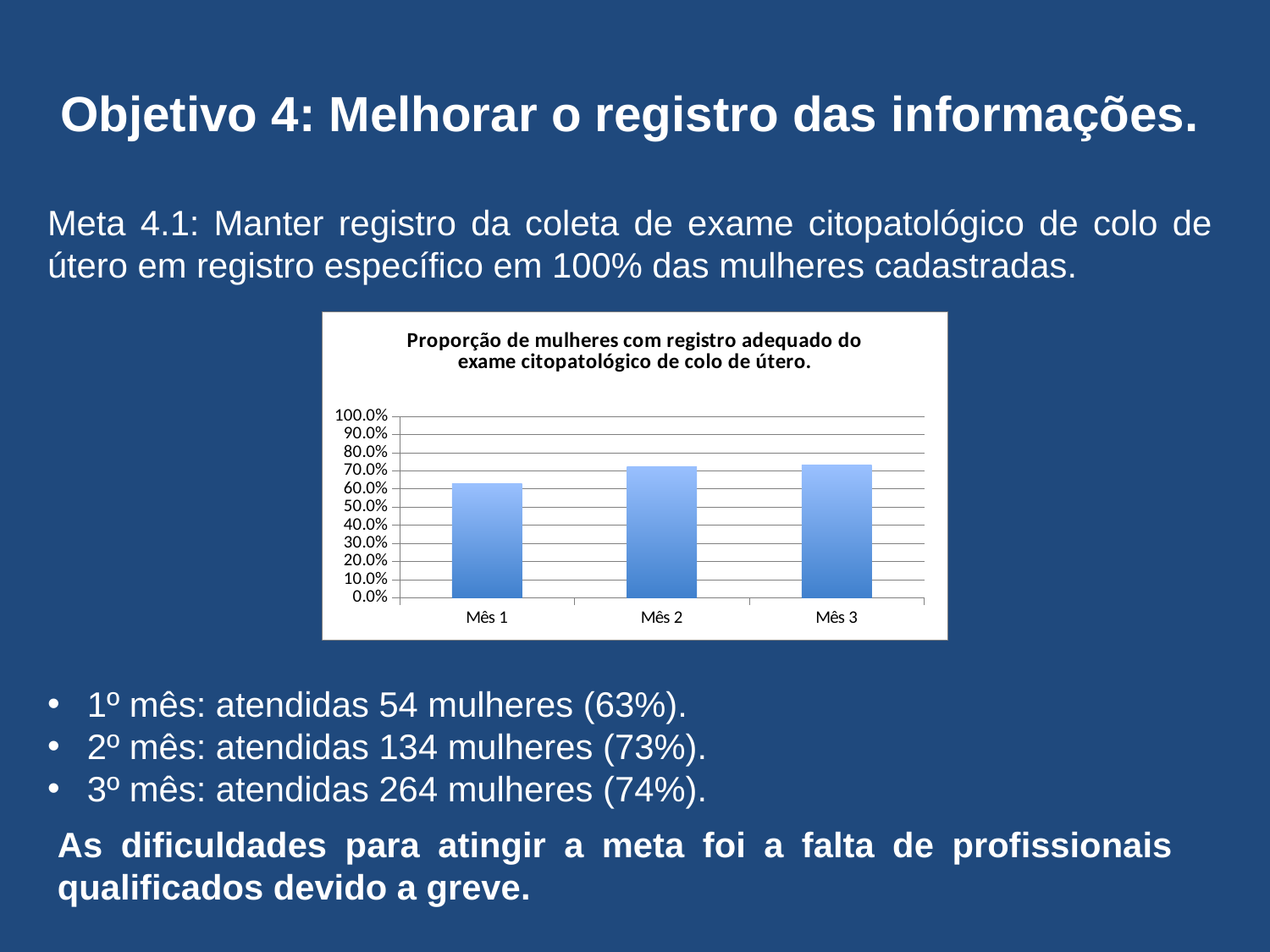
Is the value for Mês 1 greater or less than 70%? less What is the highest value shown on the chart's vertical axis? 100.0% Do the values rise or fall from Mês 1 to Mês 3? rise Is the value for Mês 3 greater or less than 60%? greater Is the value for Mês 2 greater or less than 80%? less How many categories (months) are plotted on the chart? 3 What kind of chart is shown on the slide? bar chart Which is larger, the value for Mês 1 or the value for Mês 2? Mês 2 Which month has the lowest proportion of women with adequate registration? Mês 1 What is the title of the chart? Proporção de mulheres com registro adequado do exame citopatológico de colo de útero.